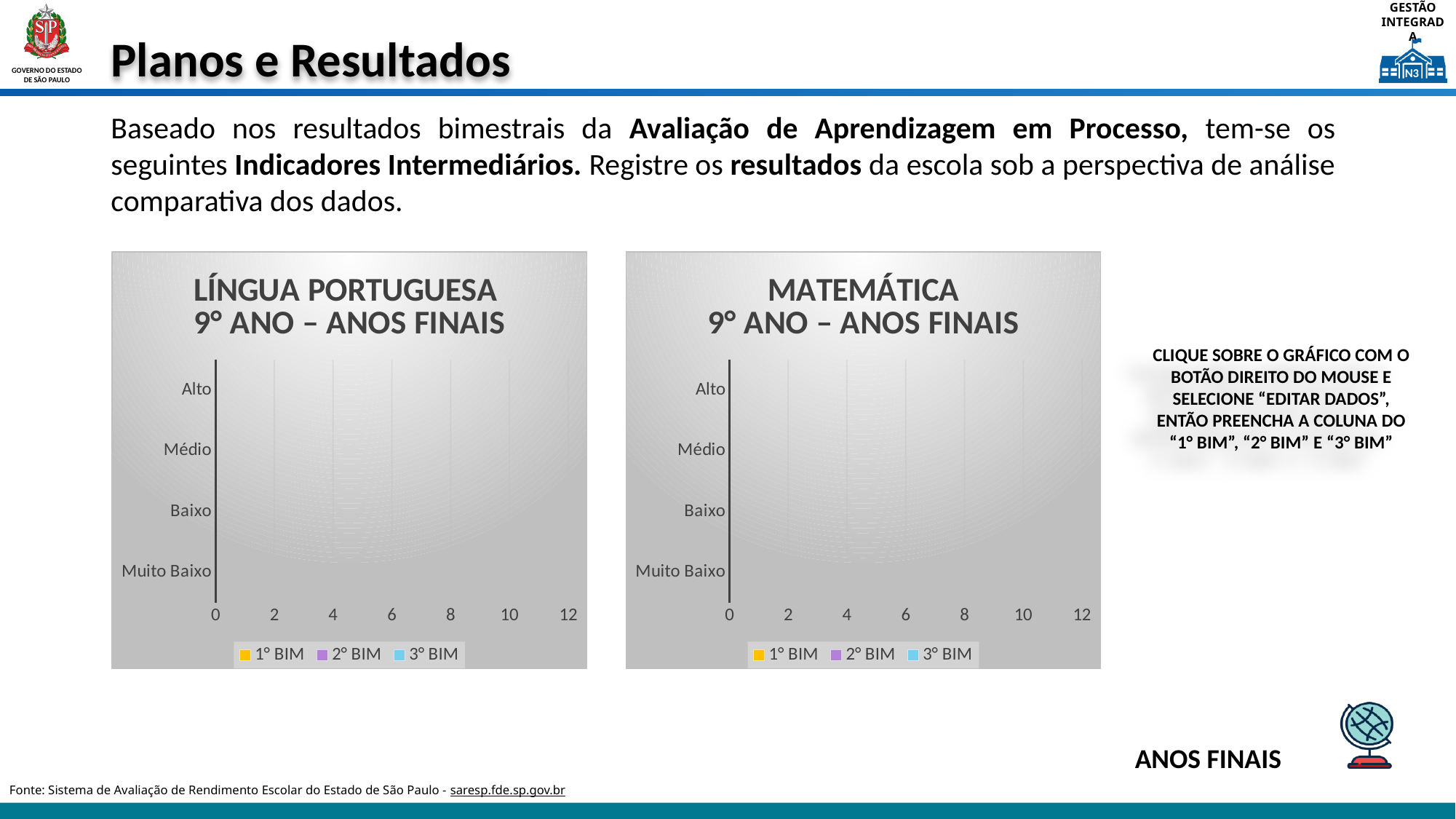
In the MATEMÁTICA 9º ANO – ANOS FINAIS chart, how many series does the legend list? 3 In the LÍNGUA PORTUGUESA 9º ANO – ANOS FINAIS chart, how many series does the legend list? 3 How many charts are shown on the slide? 2 In the MATEMÁTICA 9º ANO – ANOS FINAIS chart, what is the highest value shown on the horizontal axis? 12 In the MATEMÁTICA 9º ANO – ANOS FINAIS chart, how many categories are shown on the vertical axis? 4 What is the title of the chart on the right side of the slide? MATEMÁTICA 9º ANO – ANOS FINAIS In the LÍNGUA PORTUGUESA 9º ANO – ANOS FINAIS chart, what are the series names listed in the legend? 1º BIM, 2º BIM, 3º BIM In the LÍNGUA PORTUGUESA 9º ANO – ANOS FINAIS chart, what is the lowest category label on the vertical axis? Muito Baixo In the LÍNGUA PORTUGUESA 9º ANO – ANOS FINAIS chart, how many categories are shown on the vertical axis? 4